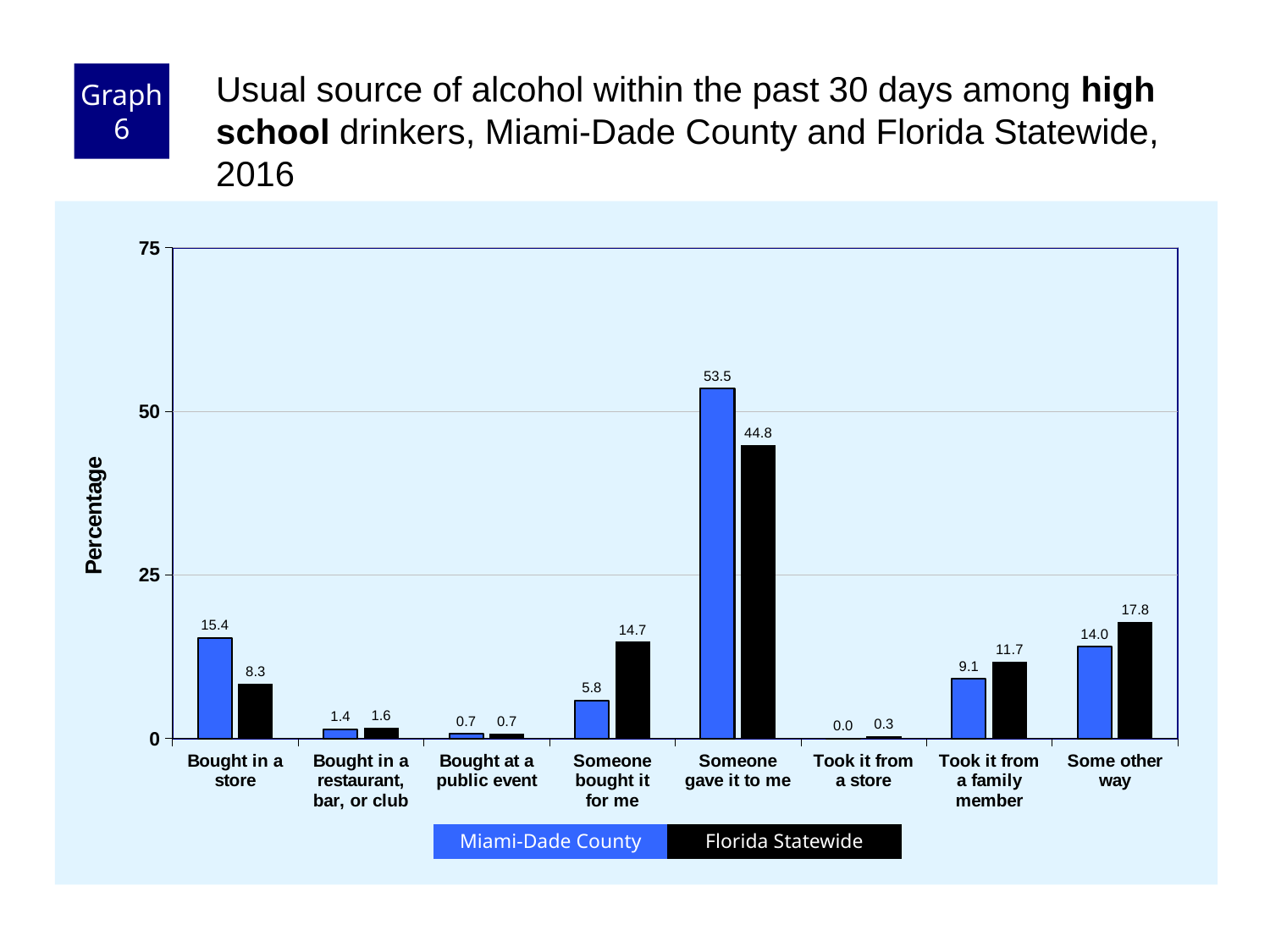
For "Someone bought it for me", which is larger: Miami-Dade County or Florida Statewide? Florida Statewide Which category has the lowest Miami-Dade County value? Took it from a store What is the Miami-Dade County value for "Someone gave it to me"? 53.5 What is the label of the y axis? Percentage How many categories are shown on the x axis? 8 What is the Florida Statewide value for "Bought in a store"? 8.3 Which category has the highest Miami-Dade County value? Someone gave it to me What is the Florida Statewide value for "Took it from a store"? 0.3 What is the difference between the Miami-Dade County and Florida Statewide values for "Someone gave it to me"? 8.7 Is the Florida Statewide value for "Someone gave it to me" greater or less than 50? less What kind of chart is shown on the slide? bar chart How many series does the legend list? 2